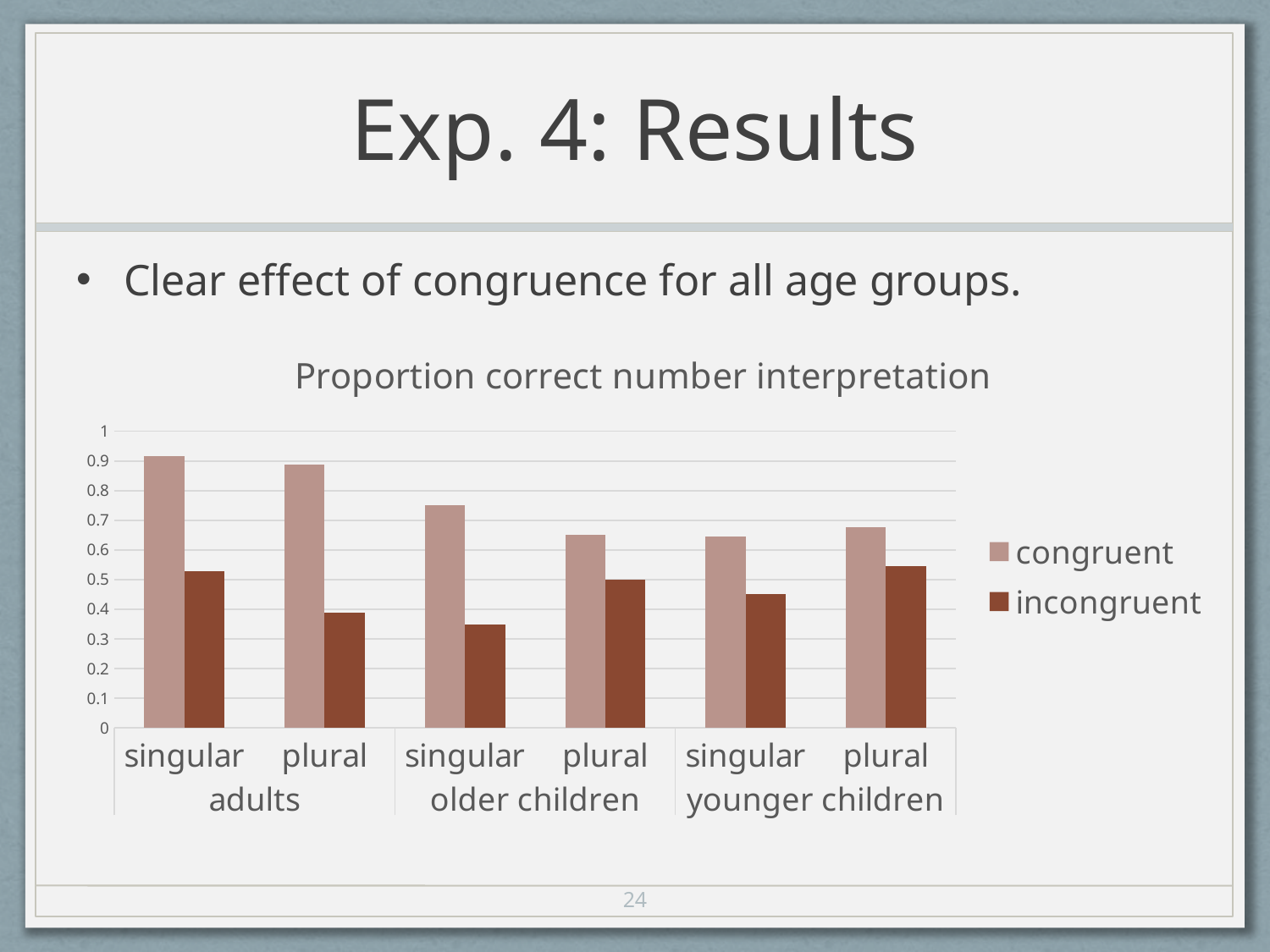
What is the title of the chart? Proportion correct number interpretation Which is larger: the congruent value for adults singular or the congruent value for older children plural? adults singular Which series is shown in the darker brown colour in the chart? incongruent Is the congruent value for older children singular greater or less than 0.7? greater Is the incongruent value for adults plural greater or less than 0.5? less Is the congruent value for adults singular greater or less than 0.9? greater How many pairs of bars (categories) are plotted in the chart? 6 How many age groups are shown along the x axis of the chart? 3 What kind of chart is shown on the slide? bar chart How many series does the chart legend list? 2 For younger children plural, which is larger: the congruent or the incongruent value? congruent